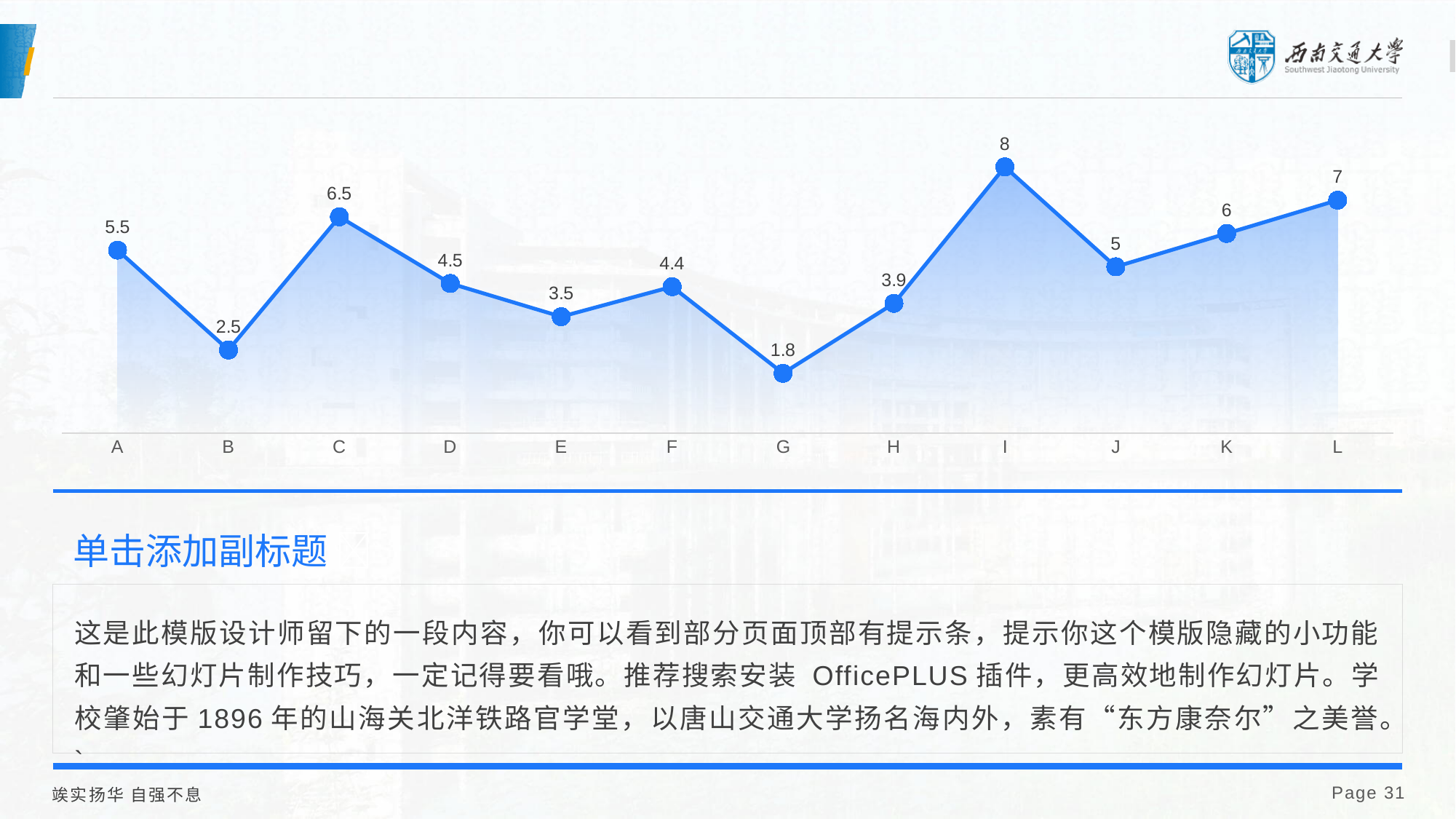
What is the value for category H? 3.9 What is the difference between the values for I and G? 6.2 What kind of chart is shown on the slide? line chart How many categories are plotted on the x axis? 12 What is the value for category C? 6.5 Which category has the highest value? I Which category has the lowest value? G Which is larger, the value for D or the value for F? D What is the difference between the values for A and B? 3 Do the values rise or fall from J to L? rise What is the value for category L? 7 What is the value for category G? 1.8